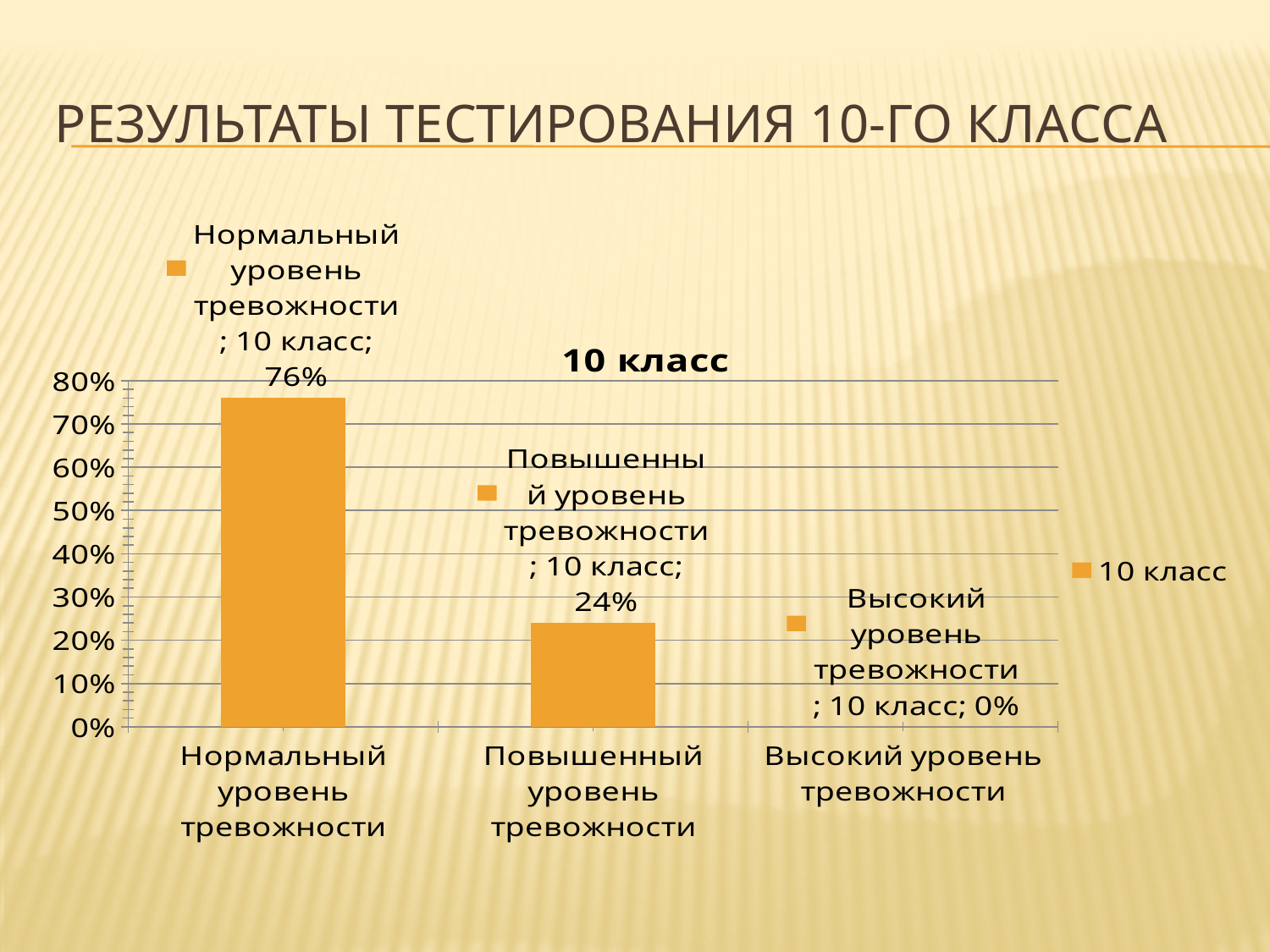
Which category has the lowest value? Высокий уровень тревожности What is the difference between the values for Нормальный уровень тревожности and Повышенный уровень тревожности? 52% What is the value for Высокий уровень тревожности? 0% What is the value for Повышенный уровень тревожности? 24% What is the value for Нормальный уровень тревожности? 76% Is the value for Нормальный уровень тревожности greater or less than 50%? greater Which is larger: the value for Повышенный уровень тревожности or Высокий уровень тревожности? Повышенный уровень тревожности How many series does the legend list? 1 What kind of chart is shown? bar chart How many categories are shown on the x axis? 3 Which category has the highest value? Нормальный уровень тревожности What is the title of the chart? 10 класс